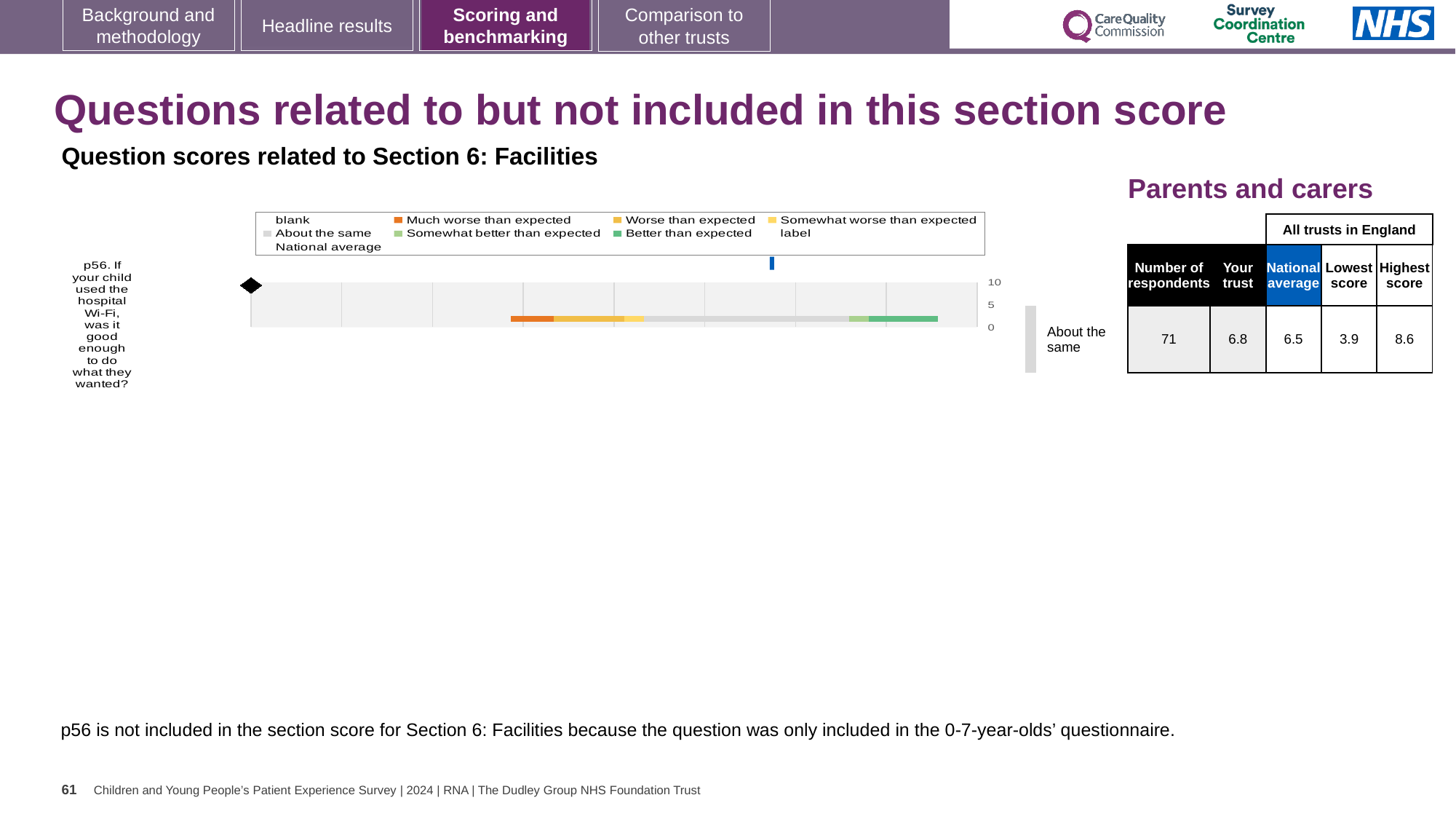
What kind of chart is shown on the slide? bar chart What is the 'Your trust' score for p56? 6.8 What is the highest score among all trusts in England for p56? 8.6 How many questions are plotted in the chart? 1 What is the lowest score among all trusts in England for p56? 3.9 Which question is plotted in the chart? p56. If your child used the hospital Wi-Fi, was it good enough to do what they wanted? What category is the trust's result for p56 labelled as? About the same What is the national average score for p56? 6.5 Which is larger for p56, the 'Your trust' score or the national average? Your trust How many respondents answered p56? 71 What is the difference between the 'Your trust' score and the national average for p56? 0.3 What is the difference between the highest score and the lowest score for p56? 4.7